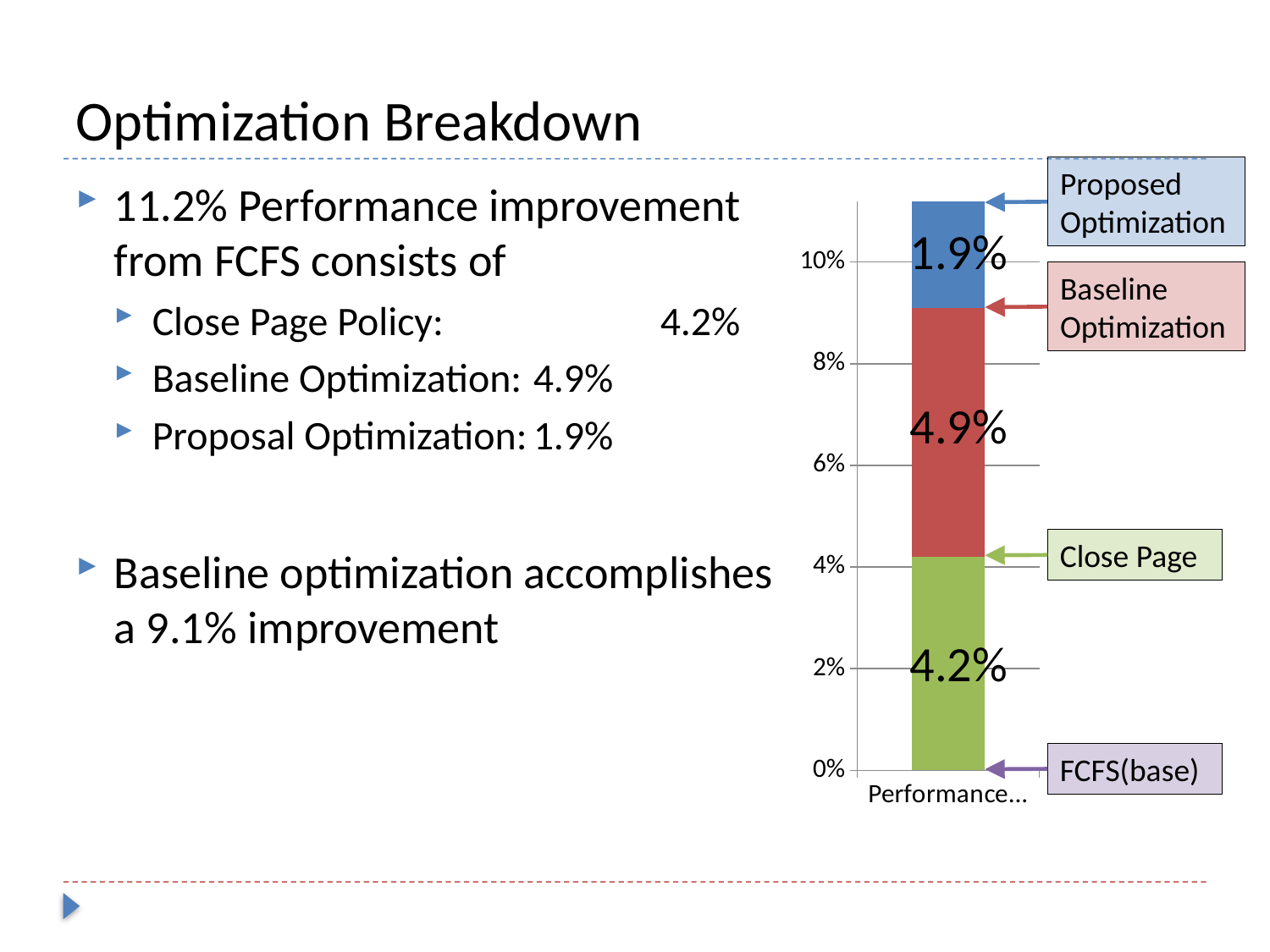
What kind of chart is shown on the slide? Stacked bar chart What is the difference between the Close Page segment and the Proposed Optimization segment? 2.3% How much larger is the Baseline Optimization segment than the Close Page segment? 0.7% Which segment of the stacked bar is the smallest? Proposed Optimization Is the top of the stacked bar greater or less than 10%? greater Which is larger, the Close Page segment or the Proposed Optimization segment? Close Page How many segments make up the stacked bar? 3 What is the value of the Baseline Optimization segment in the stacked bar? 4.9% What is the value of the Close Page segment in the stacked bar? 4.2% What colour is the Close Page segment of the bar? Green What is the value of the Proposed Optimization segment in the stacked bar? 1.9% Which segment of the stacked bar is the largest? Baseline Optimization